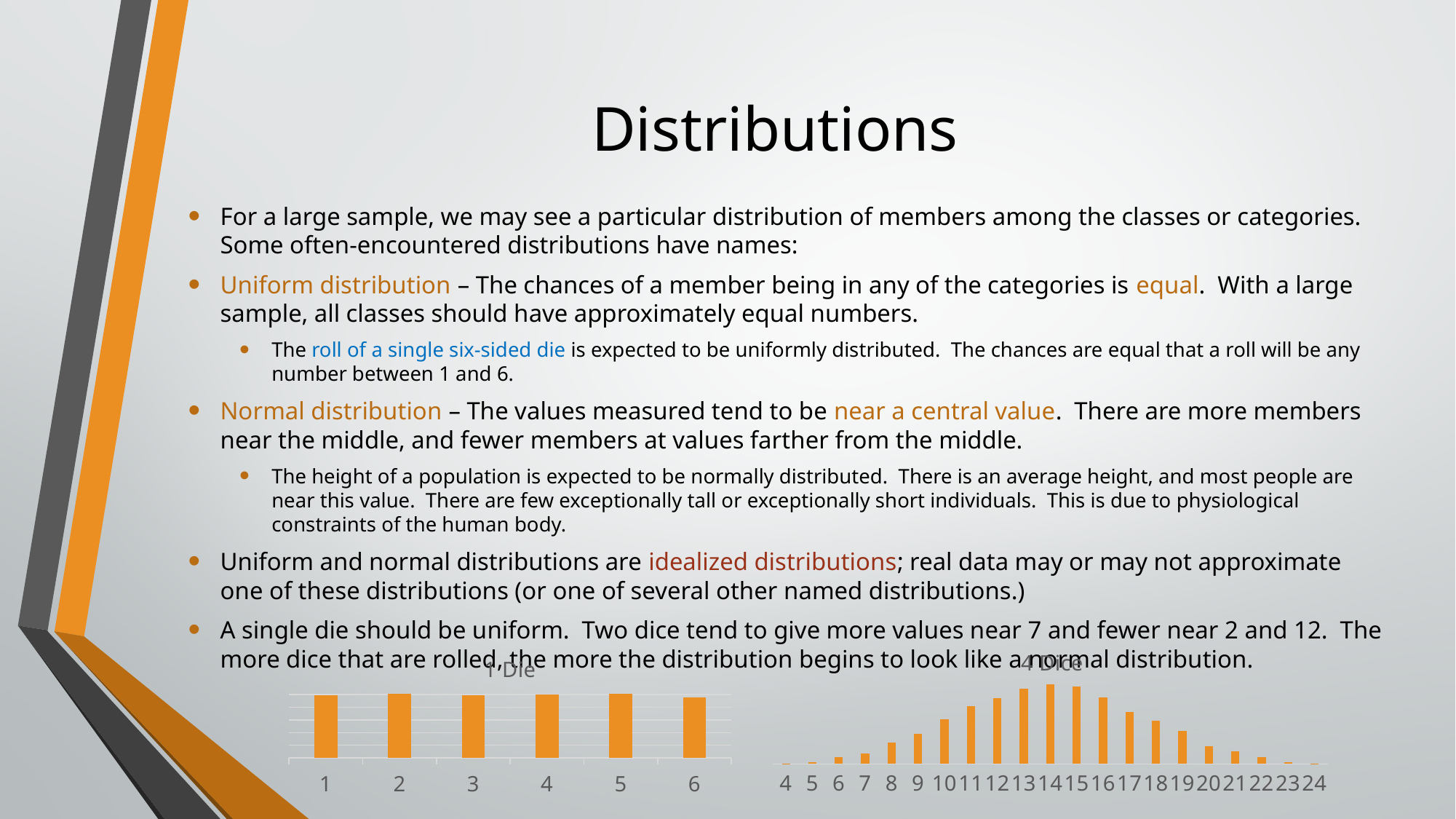
In the '4 Dice' chart, which bar is taller, the one for 17 or the one for 22? 17 What kind of chart is the '4 Dice' chart on the right of the slide? bar chart What is the title of the chart on the left of the slide? 1 Die How many categories are shown on the x axis of the '1 Die' chart? 6 What kind of chart is the '1 Die' chart on the left of the slide? bar chart In the '4 Dice' chart, which bar is taller, the one for 10 or the one for 20? 10 In the '4 Dice' chart, which bar is taller, the one for 8 or the one for 13? 13 What colour are the bars in the '4 Dice' chart? orange In the '4 Dice' chart, do the bar heights rise or fall as the x axis goes from 4 to 14? rise In the '4 Dice' chart, which category has the tallest bar? 14 How many categories are shown on the x axis of the '4 Dice' chart? 21 In the '4 Dice' chart, do the bar heights rise or fall as the x axis goes from 14 to 24? fall